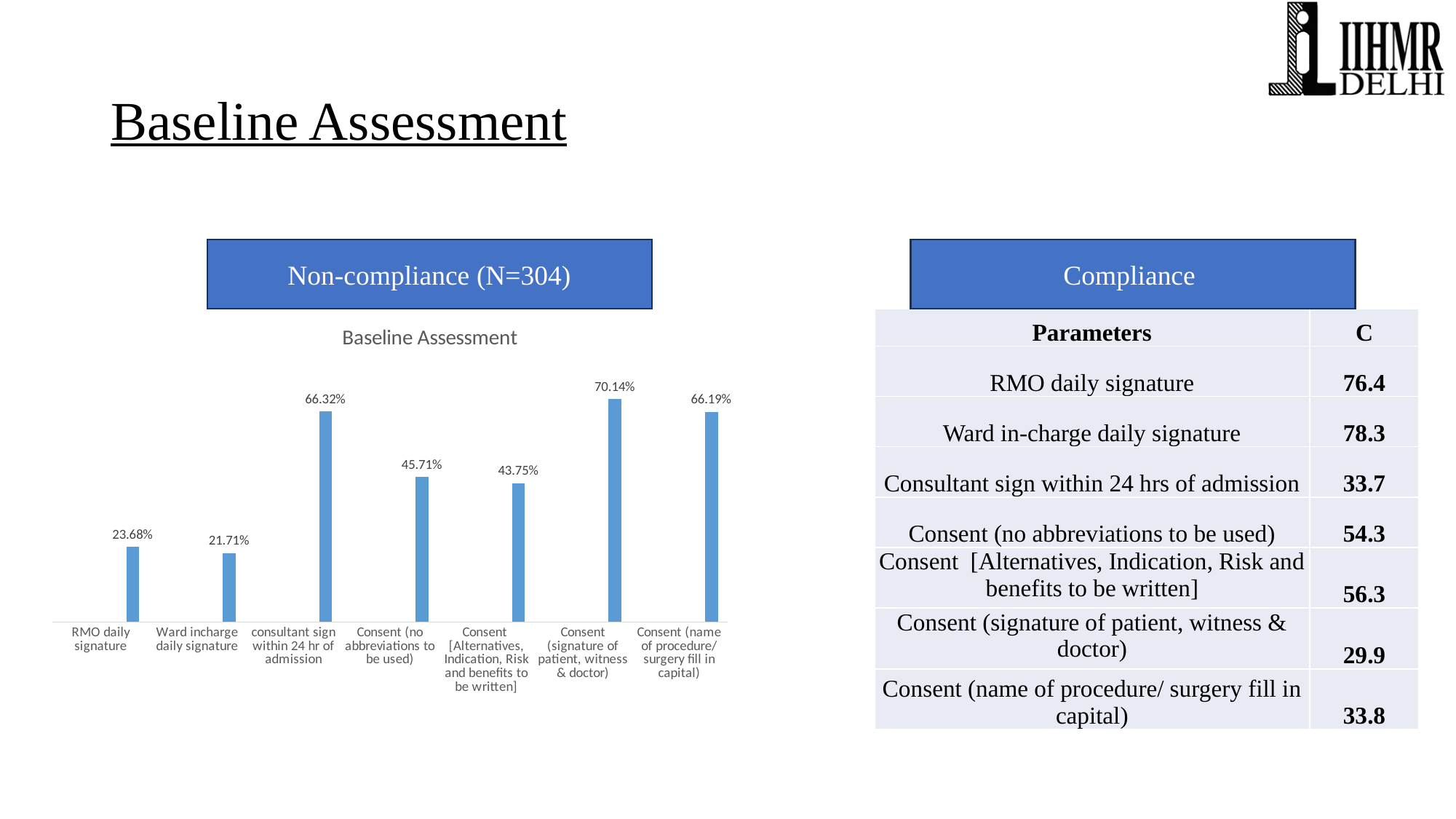
In the Baseline Assessment chart, which is larger: the value for Consent (no abbreviations to be used) or the value for Consent [Alternatives, Indication, Risk and benefits to be written]? Consent (no abbreviations to be used) In the Baseline Assessment chart, what is the difference between the values for Consent (signature of patient, witness & doctor) and consultant sign within 24 hr of admission? 3.82% What kind of chart is the Baseline Assessment chart? Bar chart In the Baseline Assessment chart, what is the difference between the values for RMO daily signature and Ward incharge daily signature? 1.97% Which category has the lowest value in the Baseline Assessment chart? Ward incharge daily signature What is the non-compliance value for RMO daily signature in the Baseline Assessment chart? 23.68% What is the title printed above the bar chart on the slide? Baseline Assessment What is the value shown for Consent (no abbreviations to be used) in the Baseline Assessment chart? 45.71% How many categories are plotted in the Baseline Assessment chart? 7 What is the value shown for consultant sign within 24 hr of admission in the Baseline Assessment chart? 66.32% What is the value shown for Consent (name of procedure/ surgery fill in capital) in the Baseline Assessment chart? 66.19% Which category has the highest value in the Baseline Assessment chart? Consent (signature of patient, witness & doctor)